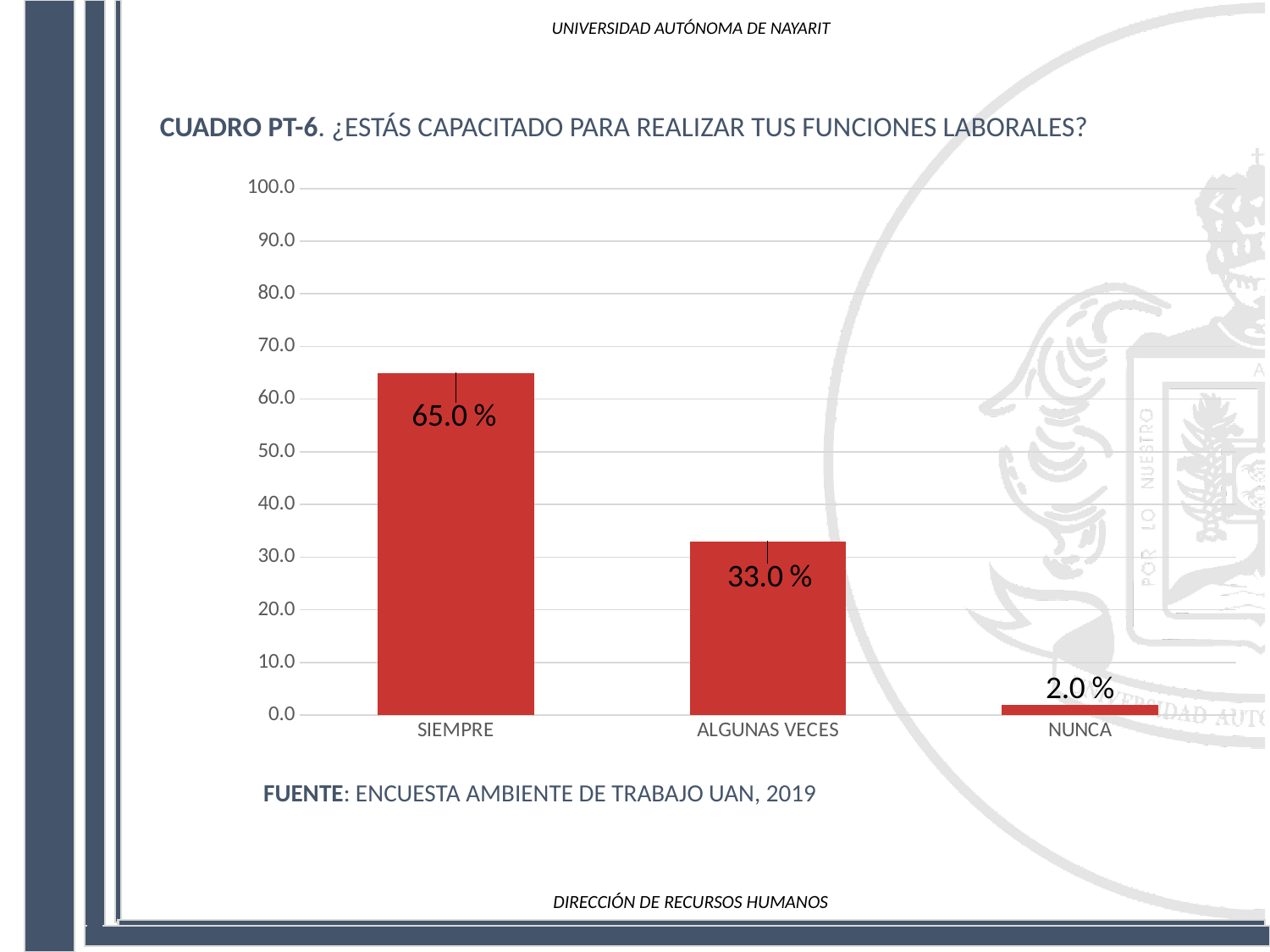
Which is larger, the value for ALGUNAS VECES or the value for NUNCA? ALGUNAS VECES How many categories are shown on the x axis? 3 What kind of chart is shown on the slide? bar chart What is the value for NUNCA? 2.0 % What is the difference between the values for ALGUNAS VECES and NUNCA? 31.0 % Which category has the highest value? SIEMPRE Is the value for SIEMPRE greater or less than 60.0? greater What is the value for SIEMPRE? 65.0 % What is the difference between the values for SIEMPRE and ALGUNAS VECES? 32.0 % Do the values rise or fall from left to right along the x axis? fall Which category has the lowest value? NUNCA What is the value for ALGUNAS VECES? 33.0 %